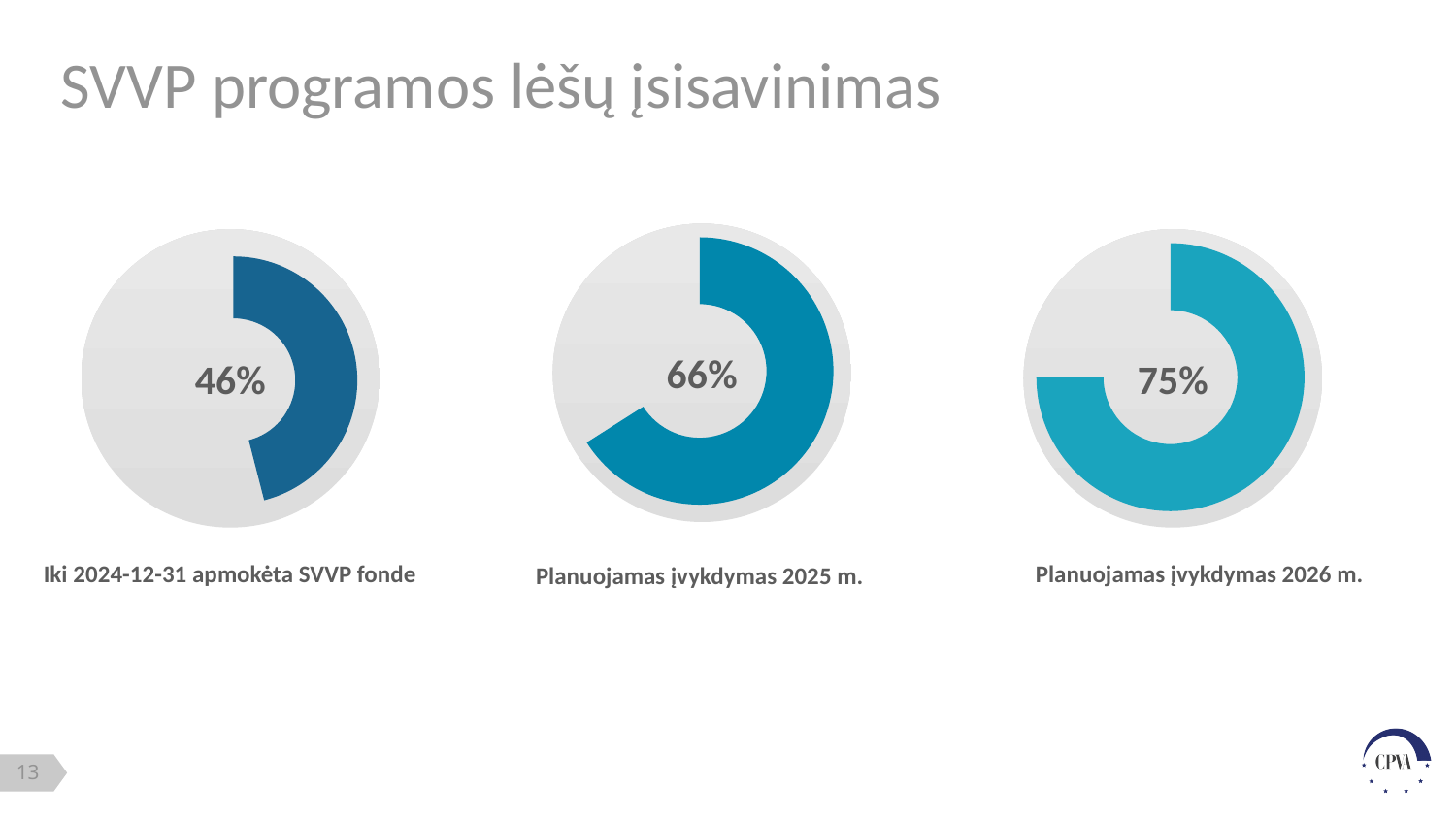
On the right chart labelled "Planuojamas įvykdymas 2026 m.", what percentage is shown? 75% What is the title of the slide containing the three charts? SVVP programos lėšų įsisavinimas Which of the three charts on the slide shows the lowest percentage? Iki 2024-12-31 apmokėta SVVP fonde What is the difference between the percentage on the "Planuojamas įvykdymas 2025 m." chart and the "Iki 2024-12-31 apmokėta SVVP fonde" chart? 20% Which is larger: the percentage on the "Planuojamas įvykdymas 2025 m." chart or on the "Iki 2024-12-31 apmokėta SVVP fonde" chart? Planuojamas įvykdymas 2025 m. How many charts are shown on the slide? 3 What kind of chart is used for the three charts on the slide? Doughnut chart Reading the three charts from left to right, do the percentages rise or fall? Rise On the left chart labelled "Iki 2024-12-31 apmokėta SVVP fonde", what percentage is shown? 46% What is the difference between the percentage on the "Planuojamas įvykdymas 2026 m." chart and the "Planuojamas įvykdymas 2025 m." chart? 9% On the middle chart labelled "Planuojamas įvykdymas 2025 m.", what percentage is shown? 66% Which of the three charts on the slide shows the highest percentage? Planuojamas įvykdymas 2026 m.